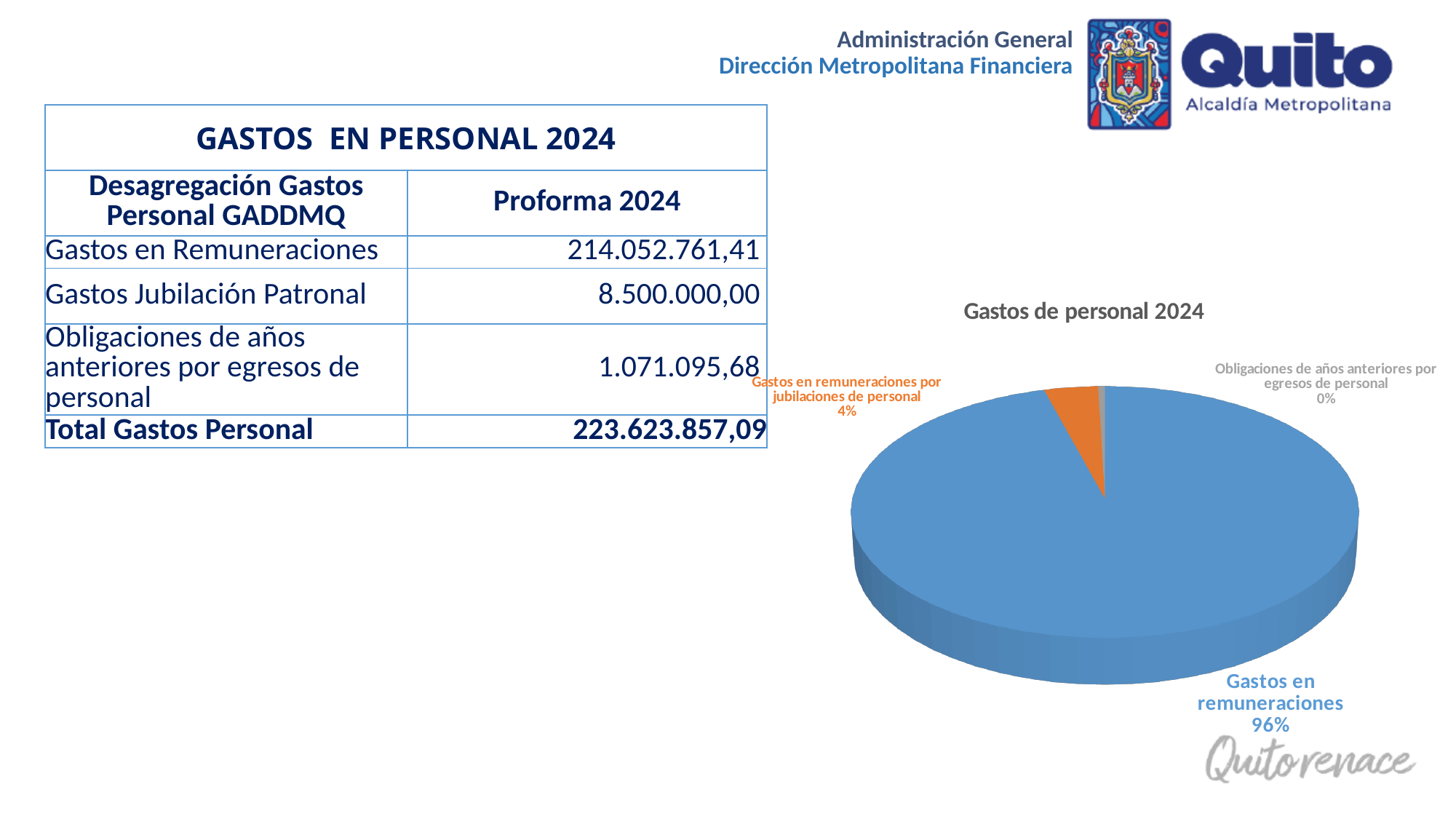
What share of the pie does 'Obligaciones de años anteriores por egresos de personal' represent? 0% What colour is the slice for 'Gastos en remuneraciones por jubilaciones de personal'? Orange Which slice of the pie is the smallest? Obligaciones de años anteriores por egresos de personal Which is larger: the slice for 'Gastos en remuneraciones' or the slice for 'Gastos en remuneraciones por jubilaciones de personal'? Gastos en remuneraciones What is the difference in percentage points between the 'Gastos en remuneraciones' slice and the 'Gastos en remuneraciones por jubilaciones de personal' slice? 92 percentage points How many slices does the pie chart have? 3 What kind of chart is shown on the slide? Pie chart What is the title of the chart? Gastos de personal 2024 What share of the pie does 'Gastos en remuneraciones por jubilaciones de personal' represent? 4% Which slice of the pie is the largest? Gastos en remuneraciones Is the share for 'Gastos en remuneraciones' greater or less than 50%? greater What share of the pie does 'Gastos en remuneraciones' represent? 96%